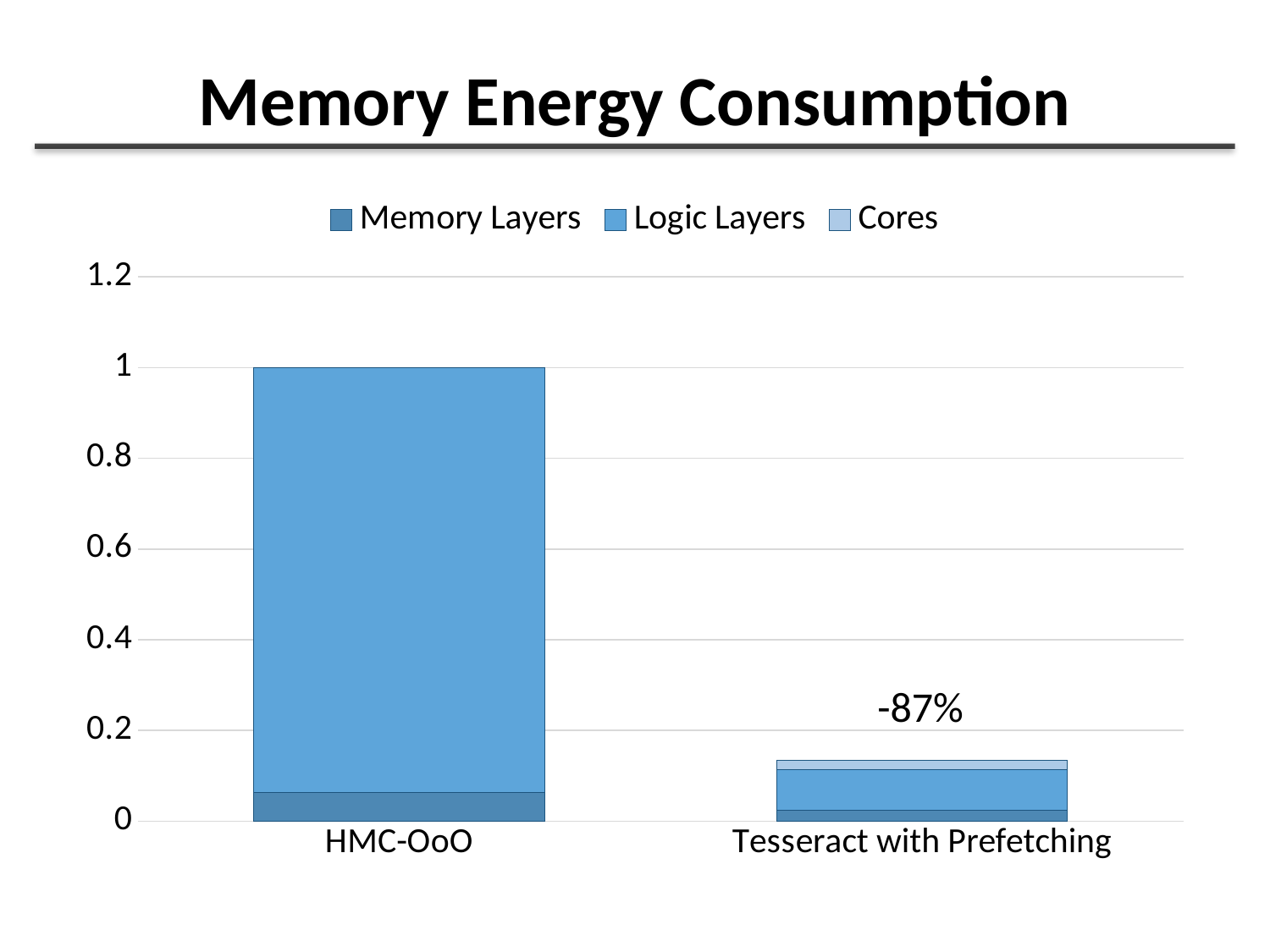
How many categories are shown on the x axis? 2 Which category has the highest total bar? HMC-OoO What kind of chart is shown on the slide? bar chart Is the total bar for HMC-OoO greater or less than 0.8? greater What is the total height of the stacked bar for HMC-OoO? 1 Which has the larger total bar, HMC-OoO or Tesseract with Prefetching? HMC-OoO Which category has the lowest total bar? Tesseract with Prefetching What percentage label is printed above the Tesseract with Prefetching bar? -87% Is the Memory Layers segment for HMC-OoO greater or less than 0.2? less How many series does the legend list? 3 Is the total bar for Tesseract with Prefetching greater or less than 0.2? less What is the title of the chart? Memory Energy Consumption